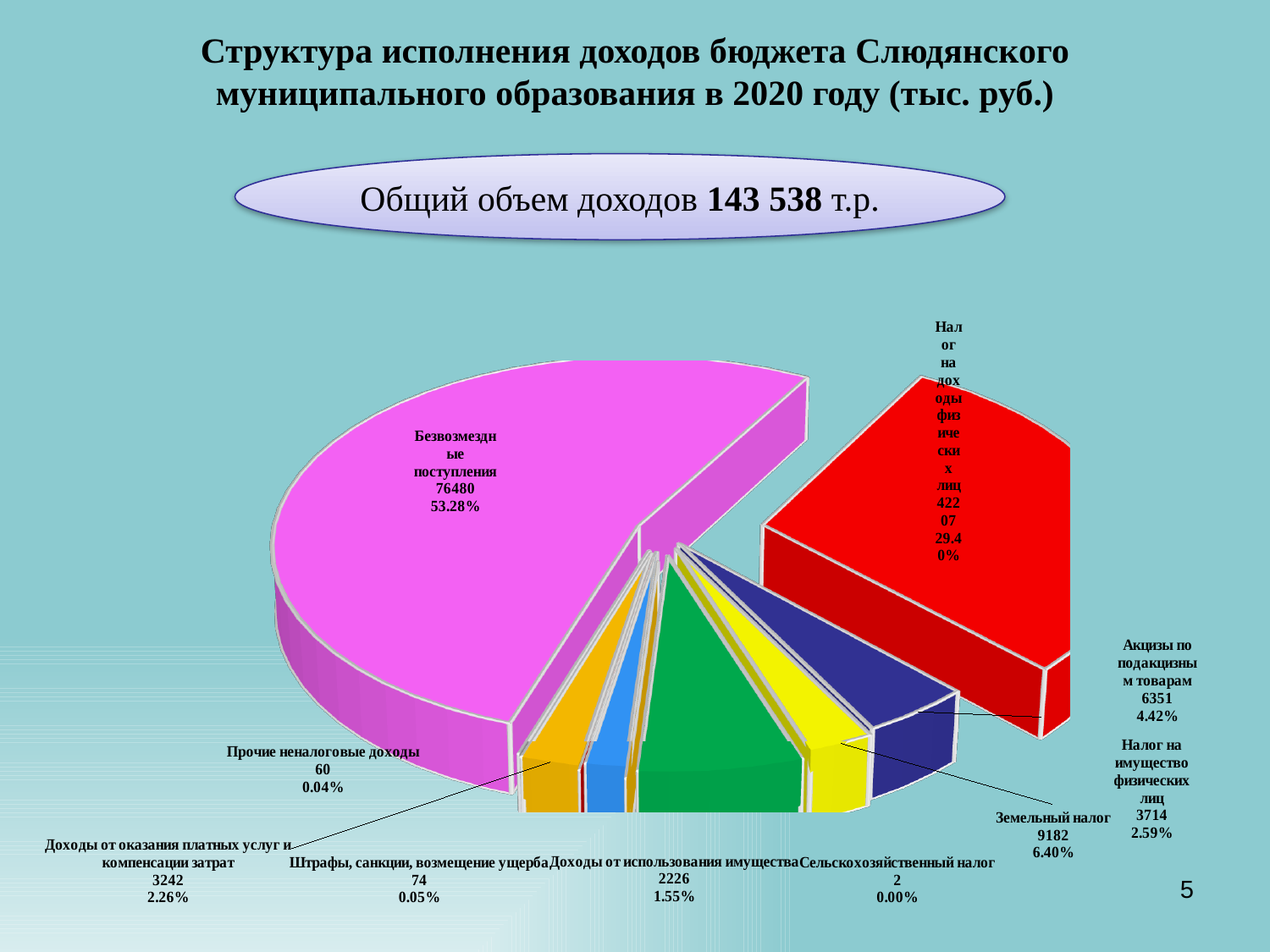
What is the value for Безвозмездные поступления? 76480 What is the value for Земельный налог? 9182 Which is larger: Налог на имущество физических лиц or Доходы от оказания платных услуг и компенсации затрат? Налог на имущество физических лиц How many categories does the pie chart show? 10 What share of the pie does Акцизы по подакцизным товарам represent? 4.42% Which category has the smallest value? Сельскохозяйственный налог What is the difference between the values for Земельный налог and Акцизы по подакцизным товарам? 2831 What total revenue volume is stated on the slide? 143 538 т.р. What share of the pie does Налог на доходы физических лиц represent? 29.40% What is the value for Штрафы, санкции, возмещение ущерба? 74 What kind of chart is shown on the slide? pie chart Which category has the largest share of the pie? Безвозмездные поступления